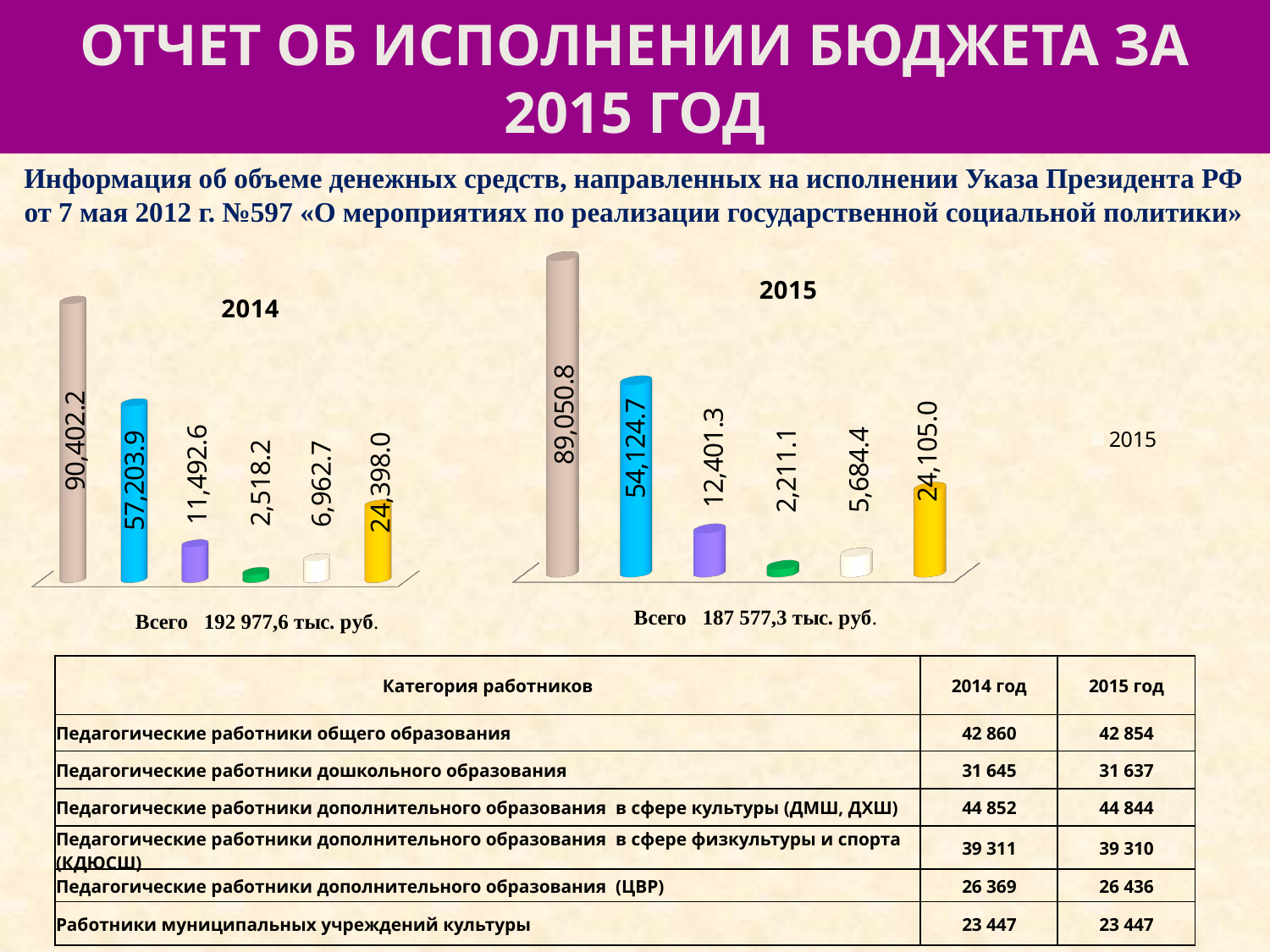
Which is larger: the first bar in the 2014 chart (90,402.2) or the first bar in the 2015 chart (89,050.8)? 2014 chart (90,402.2) In the 2015 chart, what is the value of the blue (second) bar? 54,124.7 What type of chart is the 2015 chart? bar chart In the 2015 chart, what is the value of the smallest bar? 2,211.1 In the 2014 chart, what is the value of the yellow (last) bar? 24,398.0 In the 2015 chart, what is the value of the purple (third) bar? 12,401.3 How many bars are plotted in the 2014 chart? 6 What total is printed below the 2015 chart? 187 577,3 тыс. руб. In the 2014 chart, what is the value of the smallest bar? 2,518.2 In the 2015 chart, what is the highest value shown? 89,050.8 What is the difference between the blue bar in the 2014 chart (57,203.9) and the blue bar in the 2015 chart (54,124.7)? 3,079.2 In the 2014 chart, what is the value of the tallest (first, beige) bar? 90,402.2